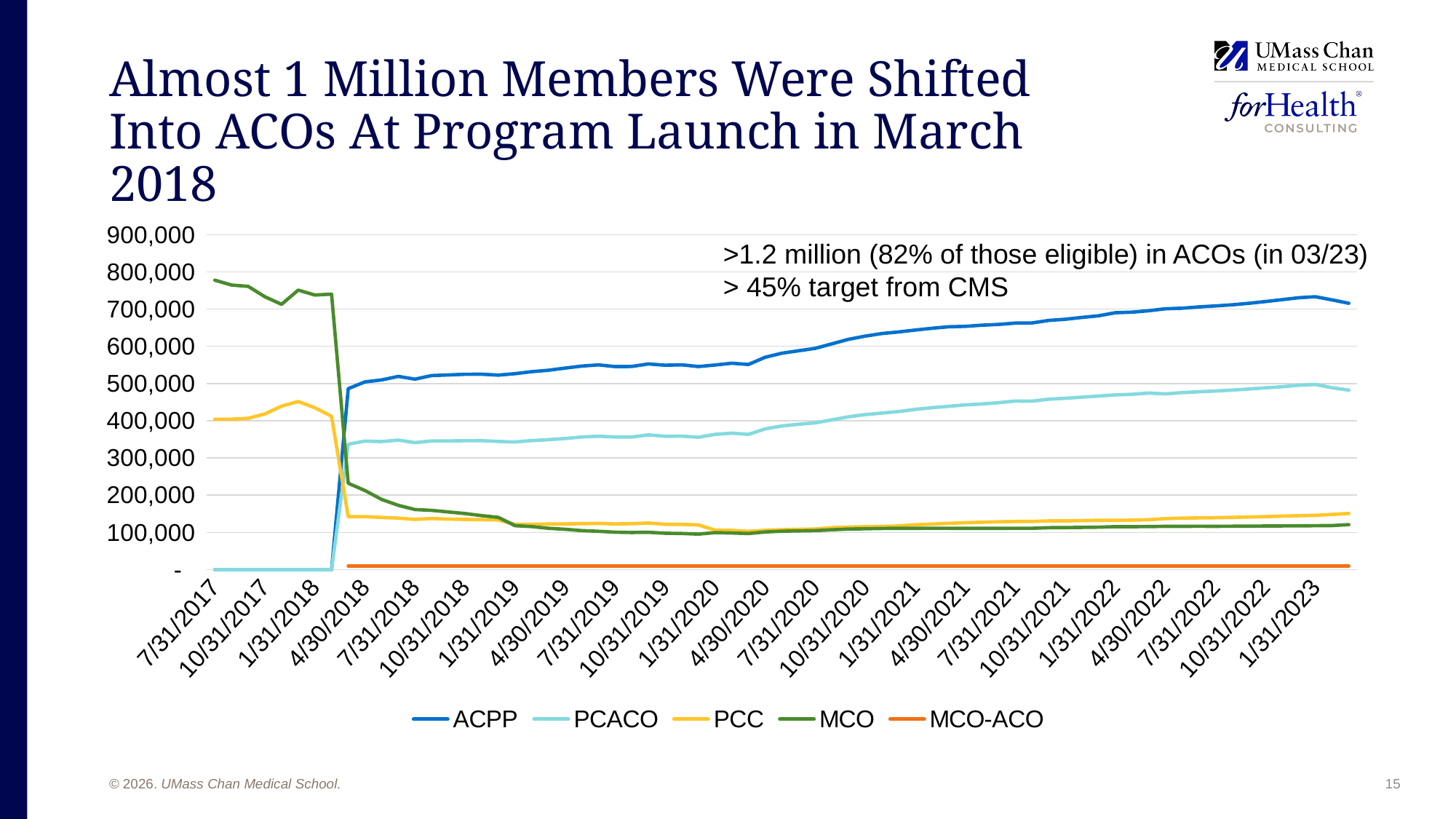
Which series has the highest value at 1/31/2023? ACPP At 7/31/2017, which is larger: MCO or PCC? MCO How many series does the chart legend list? 5 Is the value for MCO at 7/31/2017 greater or less than 700,000? greater Is the value for PCACO at 1/31/2023 greater or less than 400,000? greater Which series has the highest value at 7/31/2017? MCO What kind of chart is shown on the slide? line chart At 1/31/2023, which is larger: ACPP or PCACO? ACPP Which series has the lowest values across the period after 4/30/2018? MCO-ACO What colour is the MCO-ACO line in the legend? orange Does the ACPP line generally rise or fall from 4/30/2018 to 1/31/2023? rise Is the value for PCC at 7/31/2019 greater or less than 200,000? less